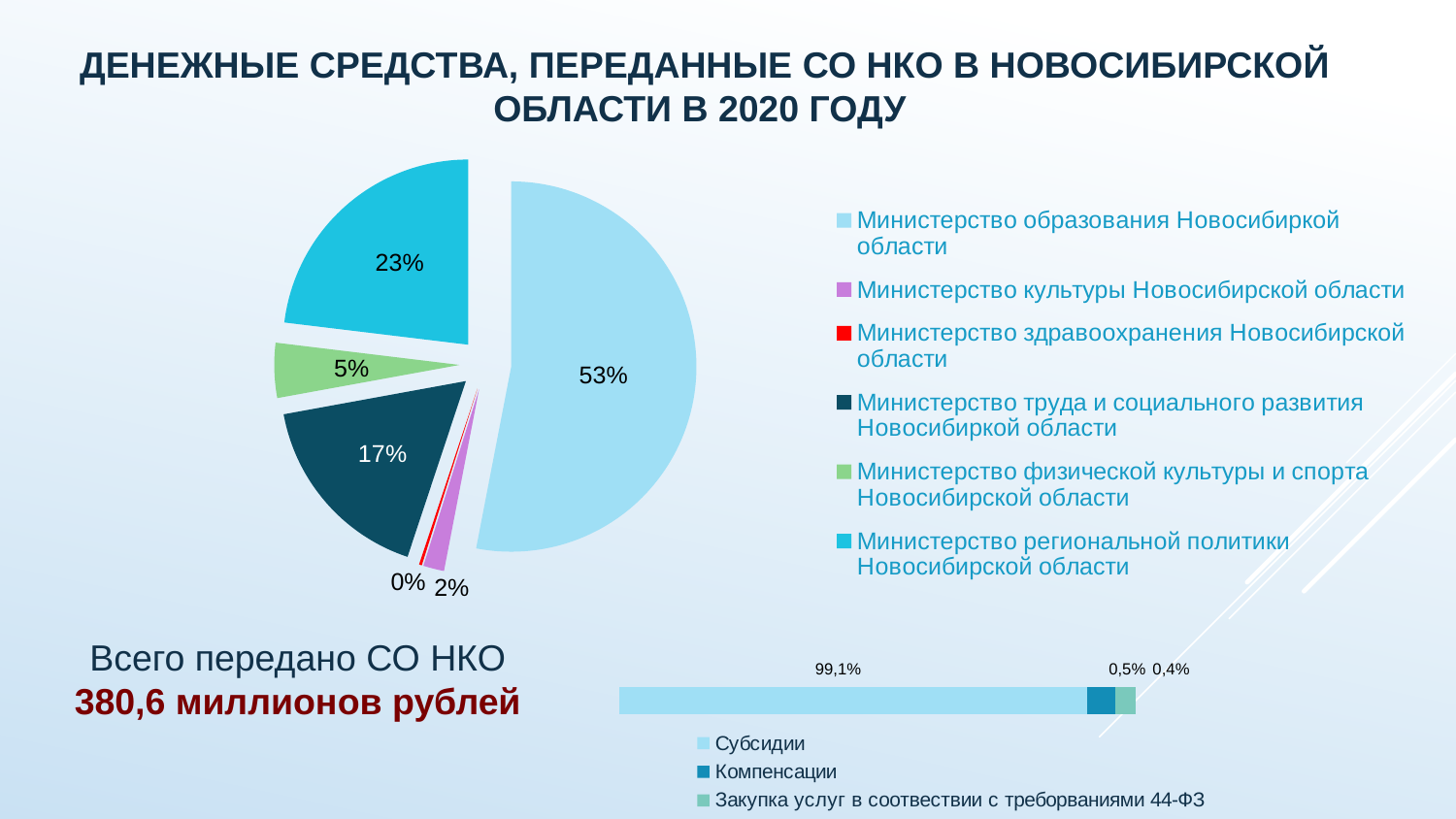
In the pie chart, what share of funds went to Министерство образования Новосибирской области? 53% In the pie chart, which ministry received the largest share of funds? Министерство образования Новосибирской области In the bar chart at the bottom of the slide, what is the value for Компенсации? 0,5% In the pie chart, which ministry received the smallest share of funds? Министерство здравоохранения Новосибирской области What kind of chart is shown at the top left of the slide? Pie chart In the pie chart, what is the difference in percentage points between the share for Министерство региональной политики and the share for Министерство физической культуры и спорта? 18 How many slices does the pie chart have? 6 How many series does the legend of the bar chart at the bottom of the slide list? 3 In the pie chart, what share of funds went to Министерство региональной политики Новосибирской области? 23% In the bar chart at the bottom of the slide, what is the value for Субсидии? 99,1% In the pie chart, what share of funds went to Министерство труда и социального развития Новосибирской области? 17% In the pie chart, which received a larger share: Министерство труда и социального развития or Министерство культуры? Министерство труда и социального развития